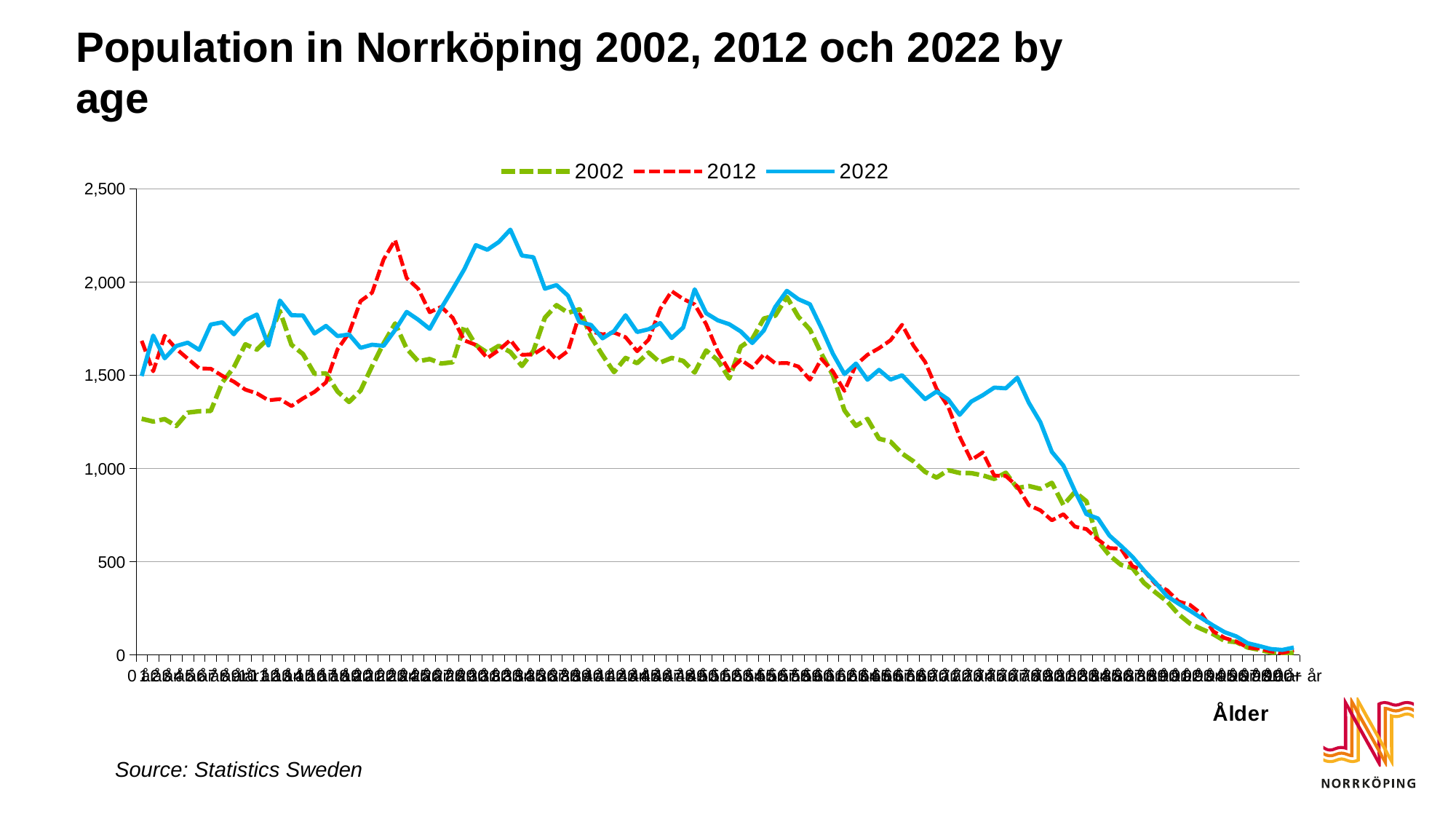
Which years are listed in the chart legend? 2002, 2012 and 2022 Is the highest point of the 2012 line greater or less than 2,000? greater What kind of chart is shown on the slide? Line chart How many series does the legend list? 3 Toward the right end of the x axis, do the values of all three series rise or fall? fall Is the value of the 2002 line at the far left of the x axis greater or less than 1,500? less Is the highest point of the 2022 line greater or less than 2,000? greater Which series has the lowest values at the far left of the x axis? 2002 Which series is drawn as a solid line rather than a dashed line? 2022 What is the highest value shown on the vertical axis? 2,500